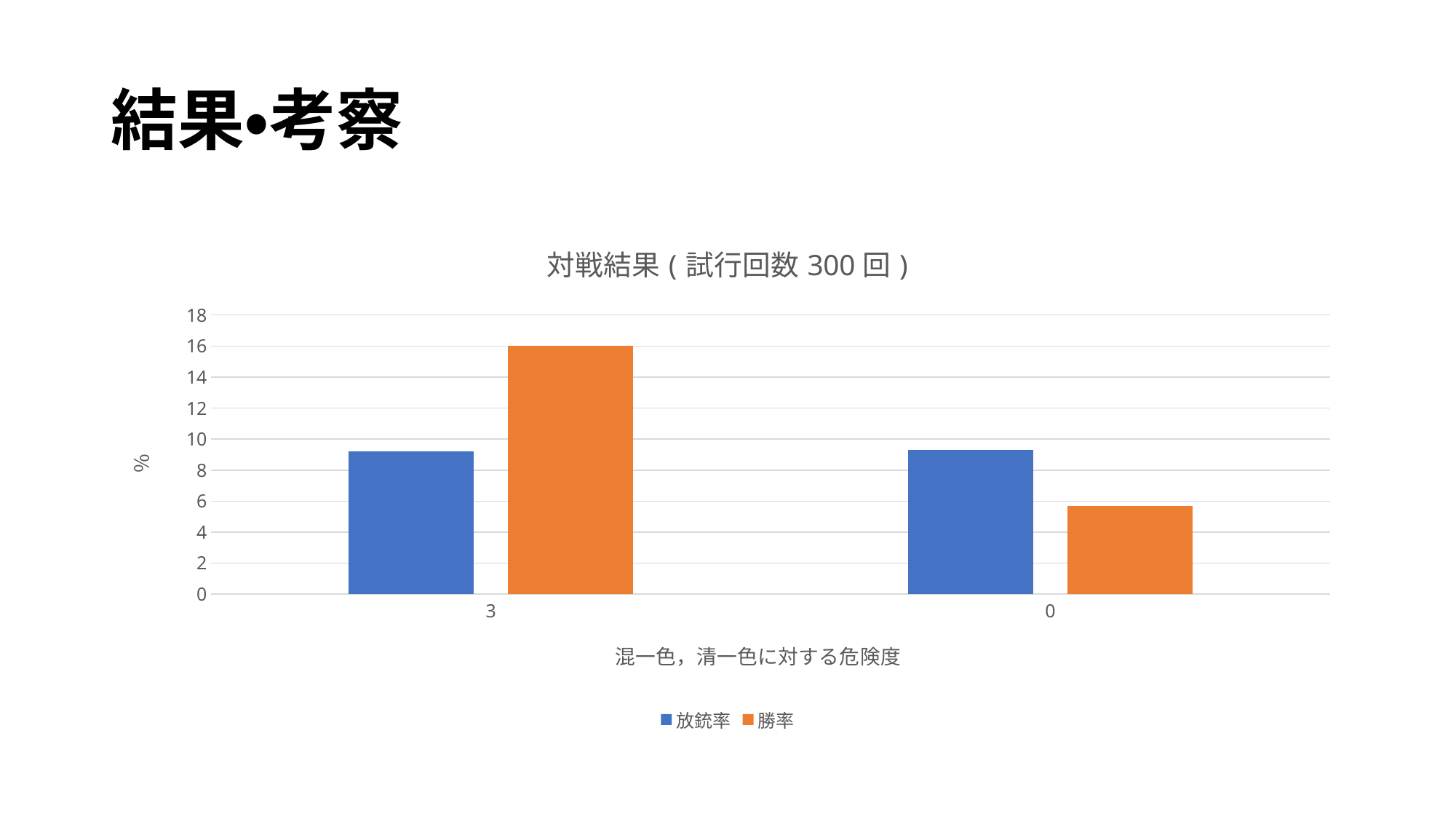
Which bar is the shortest in the chart? 勝率 at category 0 What is the title of the chart? 対戦結果 ( 試行回数 300 回 ) How many categories are shown on the x axis? 2 What kind of chart is shown on the slide? bar chart What is the label on the x axis of the chart? 混一色，清一色に対する危険度 How many series does the legend list? 2 Is the 勝率 value for category 3 greater or less than 14? greater For category 3, which is larger: 放銃率 or 勝率? 勝率 For category 0, which is larger: 放銃率 or 勝率? 放銃率 Which bar is the tallest in the chart? 勝率 at category 3 Is the 放銃率 value for category 3 greater or less than 10? less Is the 勝率 value for category 0 greater or less than 8? less